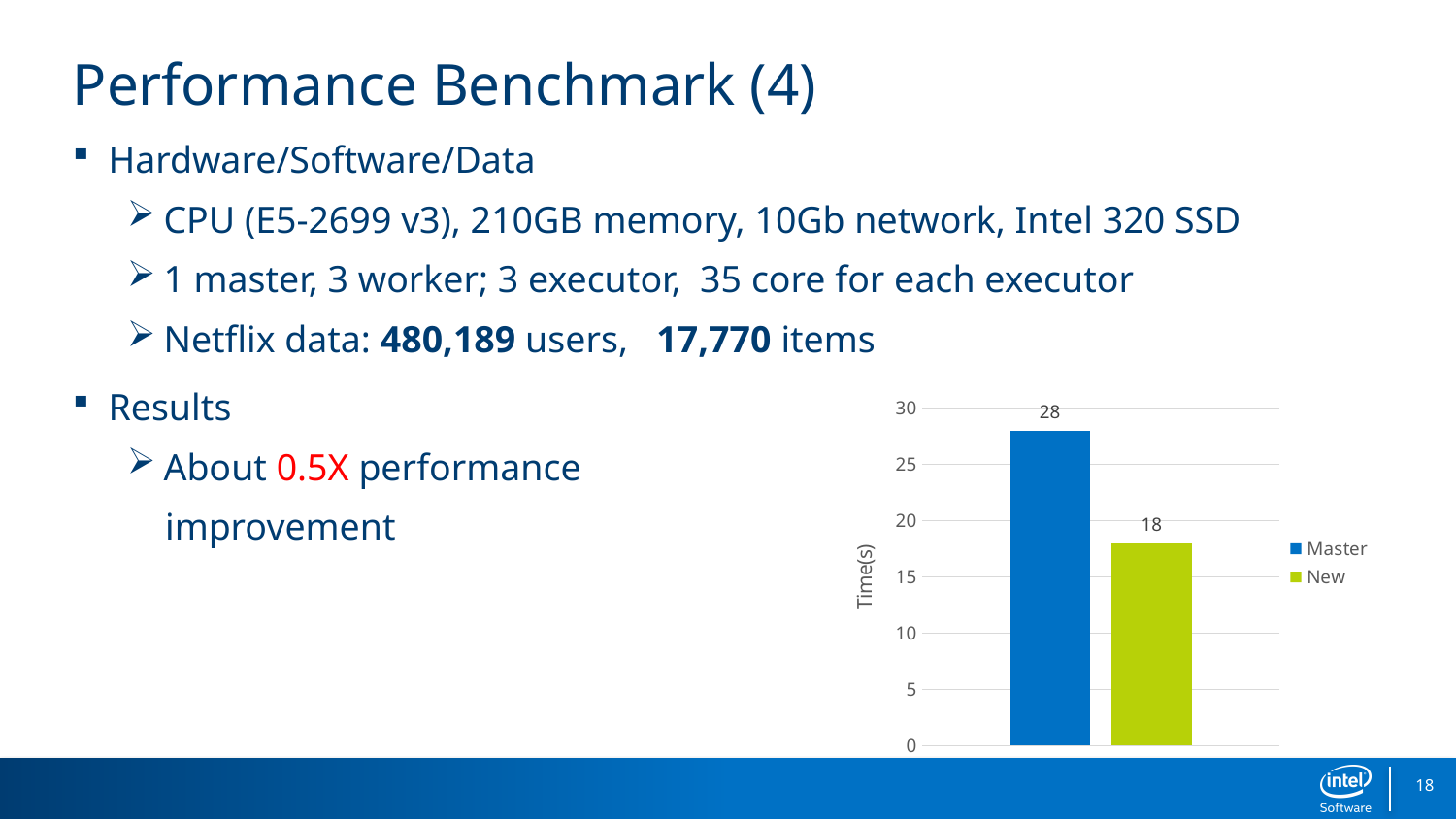
What is the value for Master in the chart? 28 What is the difference between the Master and New values? 10 What kind of chart is shown on the slide? bar chart Is the value for Master greater or less than 25? greater What is the value for New in the chart? 18 What is the maximum value shown on the vertical axis? 30 What is the label of the vertical axis? Time(s) What colour is the bar for the New series? green Which series has the lowest value in the chart? New Which series has the higher value, Master or New? Master How many series does the legend list? 2 Is the value for New greater or less than 20? less